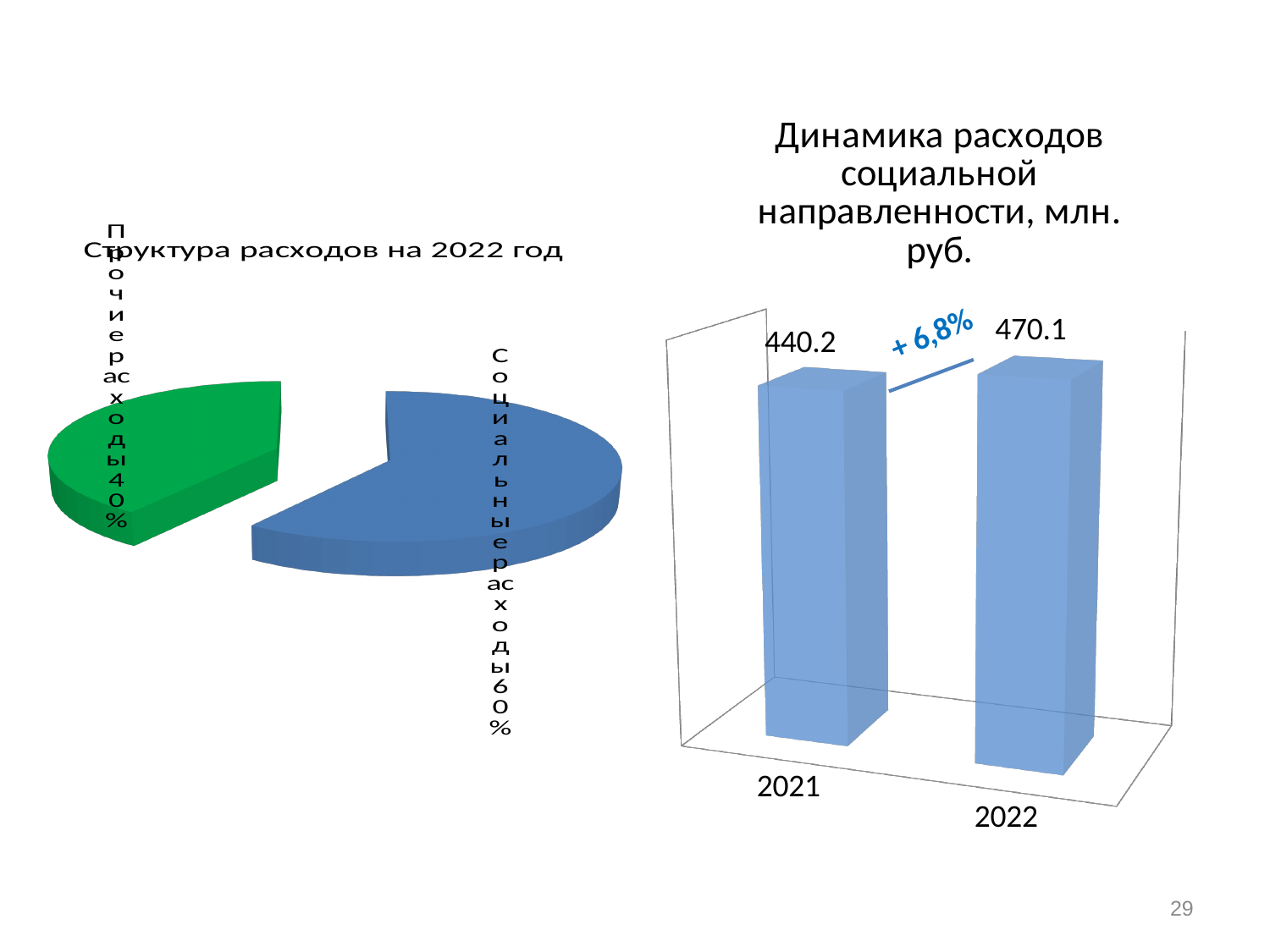
In the pie chart 'Структура расходов на 2022 год', what share is labelled for 'Прочие расходы'? 40% In the pie chart 'Структура расходов на 2022 год', what share is labelled for 'Социальные расходы'? 60% In the pie chart 'Структура расходов на 2022 год', which slice is larger: 'Социальные расходы' or 'Прочие расходы'? Социальные расходы In the chart 'Динамика расходов социальной направленности, млн. руб.', do the values rise or fall from 2021 to 2022? Rise In the chart 'Динамика расходов социальной направленности, млн. руб.', what is the difference between the 2022 and 2021 values? 29.9 How many slices does the pie chart 'Структура расходов на 2022 год' have? 2 In the pie chart 'Структура расходов на 2022 год', what colour is the 'Прочие расходы' slice? Green In the chart 'Динамика расходов социальной направленности, млн. руб.', what percentage change is annotated between the two bars? + 6,8% What kind of chart is 'Динамика расходов социальной направленности, млн. руб.'? Bar chart In the chart 'Динамика расходов социальной направленности, млн. руб.', what is the value for 2022? 470.1 In the chart 'Динамика расходов социальной направленности, млн. руб.', what is the value for 2021? 440.2 In the chart 'Динамика расходов социальной направленности, млн. руб.', which year has the higher value? 2022